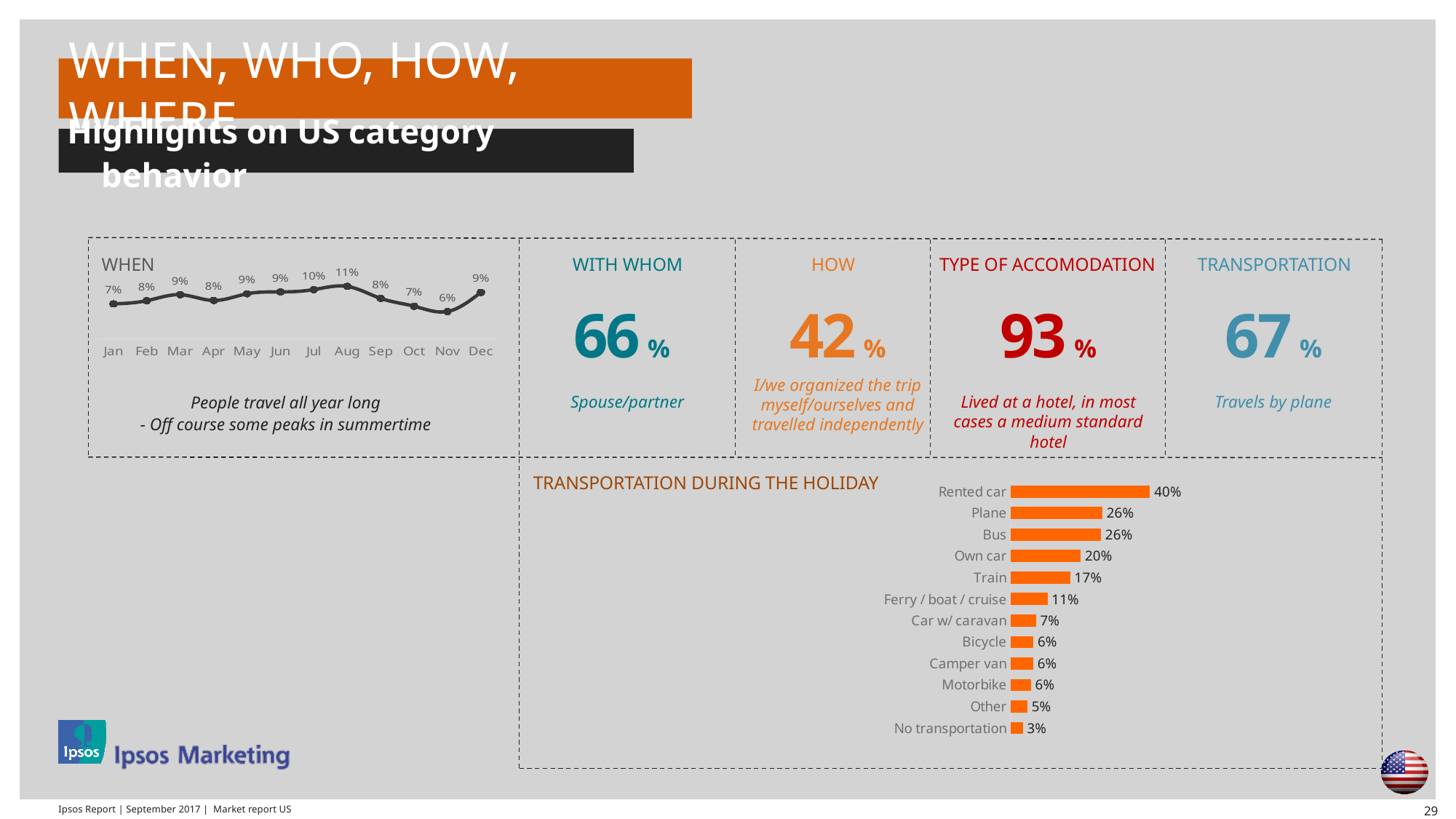
In the 'TRANSPORTATION DURING THE HOLIDAY' chart, which is larger, Train or Ferry / boat / cruise? Train What kind of chart is the 'WHEN' chart? Line chart In the 'WHEN' chart, what is the difference between Aug and Nov? 5% In the 'WHEN' chart, which month has the lowest value? Nov In the 'TRANSPORTATION DURING THE HOLIDAY' chart, what is the difference between Rented car and Own car? 20% In the 'TRANSPORTATION DURING THE HOLIDAY' chart, which category has the highest value? Rented car In the 'TRANSPORTATION DURING THE HOLIDAY' chart, what is the value for Rented car? 40% How many categories are shown in the 'TRANSPORTATION DURING THE HOLIDAY' chart? 12 What kind of chart is the 'TRANSPORTATION DURING THE HOLIDAY' chart? Bar chart In the 'WHEN' chart, what is the value for Aug? 11% In the 'TRANSPORTATION DURING THE HOLIDAY' chart, what is the value for Train? 17% In the 'TRANSPORTATION DURING THE HOLIDAY' chart, which category has the lowest value? No transportation